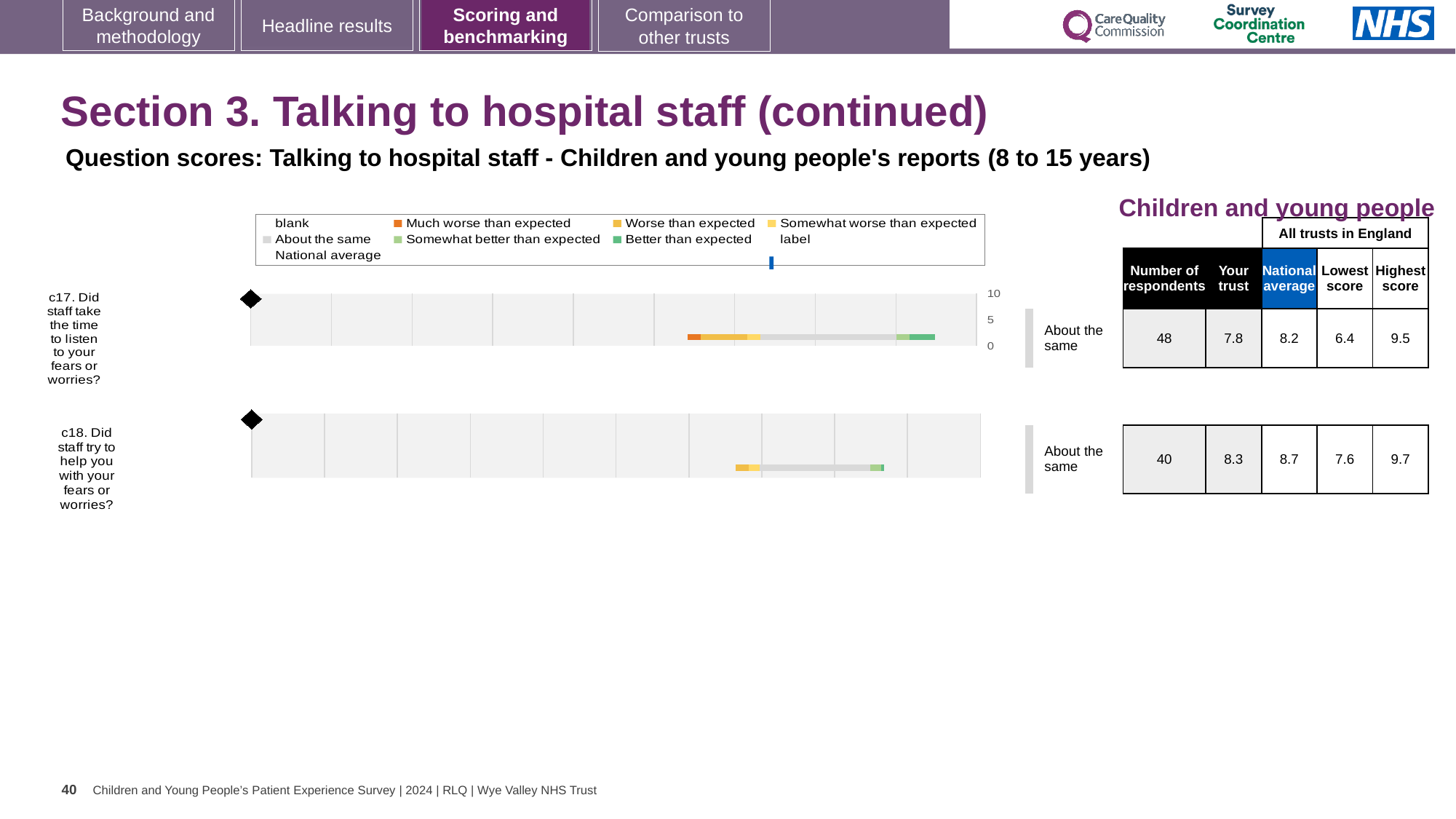
What benchmark category is shown for c17? About the same How many survey questions are plotted on the slide? 2 By how much does the national average exceed the 'Your trust' score for c17? 0.4 For c17, which is larger: the 'Your trust' score or the national average? National average What is the 'Your trust' score for c17 (Did staff take the time to listen to your fears or worries?)? 7.8 What is the lowest score among all trusts in England for c17? 6.4 What is the difference between the highest and lowest scores for c18? 2.1 What is the national average score for c17? 8.2 How many respondents answered c18 (Did staff try to help you with your fears or worries?)? 40 Which question has the higher 'Your trust' score, c17 or c18? c18 What kind of chart is used to show the question scores for c17 and c18? bar chart What is the highest score among all trusts in England for c18? 9.7